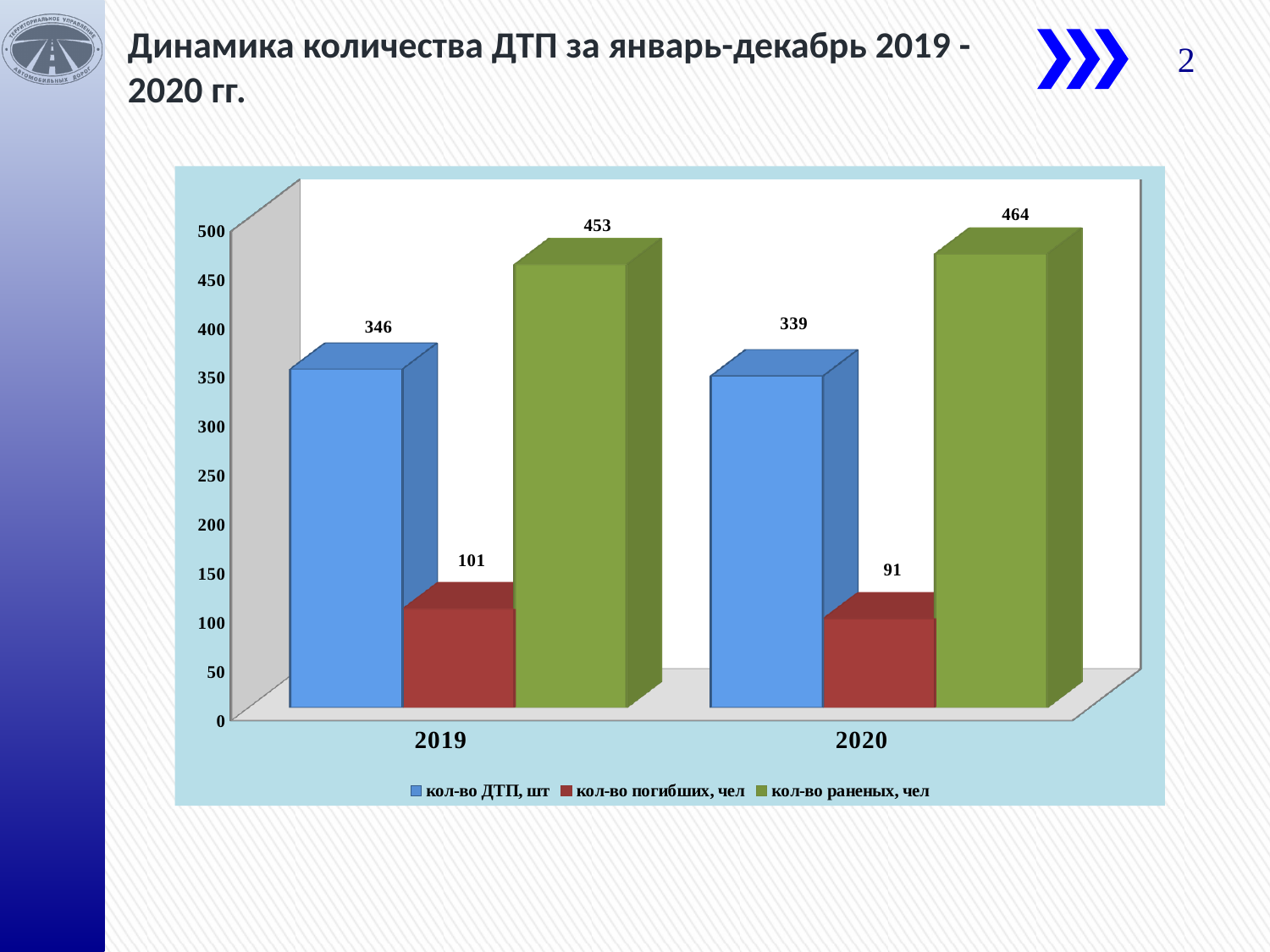
What is the value of кол-во раненых, чел for 2019? 453 How many categories are shown on the x axis? 2 What is the value of кол-во погибших, чел for 2020? 91 Does the value of кол-во ДТП, шт rise or fall from 2019 to 2020? fall What kind of chart is shown on the slide? bar chart Which series has the highest value in 2020? кол-во раненых, чел How many series does the legend list? 3 What is the value of кол-во ДТП, шт for 2019? 346 Which series has the lowest value in 2019? кол-во погибших, чел What is the difference between кол-во погибших, чел in 2019 and in 2020? 10 What is the difference between кол-во раненых, чел in 2020 and in 2019? 11 Which year has the larger value for кол-во ДТП, шт, 2019 or 2020? 2019